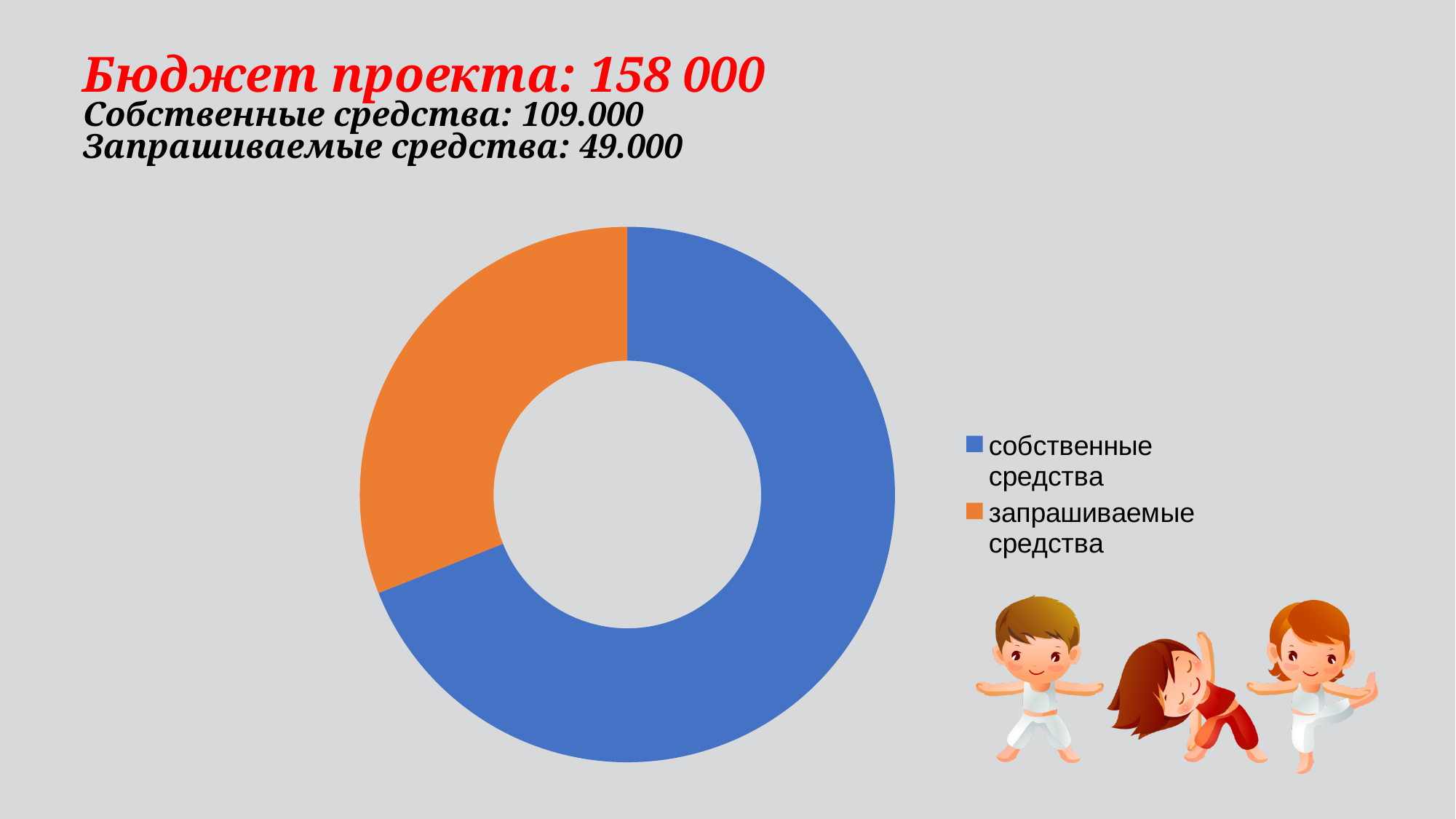
How many slices does the doughnut chart have? 2 What is the value of запрашиваемые средства according to the slide? 49.000 Does the slice for собственные средства take up more or less than half of the chart? more What colour is the slice for запрашиваемые средства? orange What is the value of собственные средства according to the slide? 109.000 Which slice of the chart is the largest? собственные средства What is the total project budget shown in the slide title? 158 000 Which is larger, собственные средства or запрашиваемые средства? собственные средства What colour is the slice for собственные средства? blue Which slice of the chart is the smallest? запрашиваемые средства What kind of chart is shown on the slide? doughnut chart How many entries does the legend of the chart list? 2